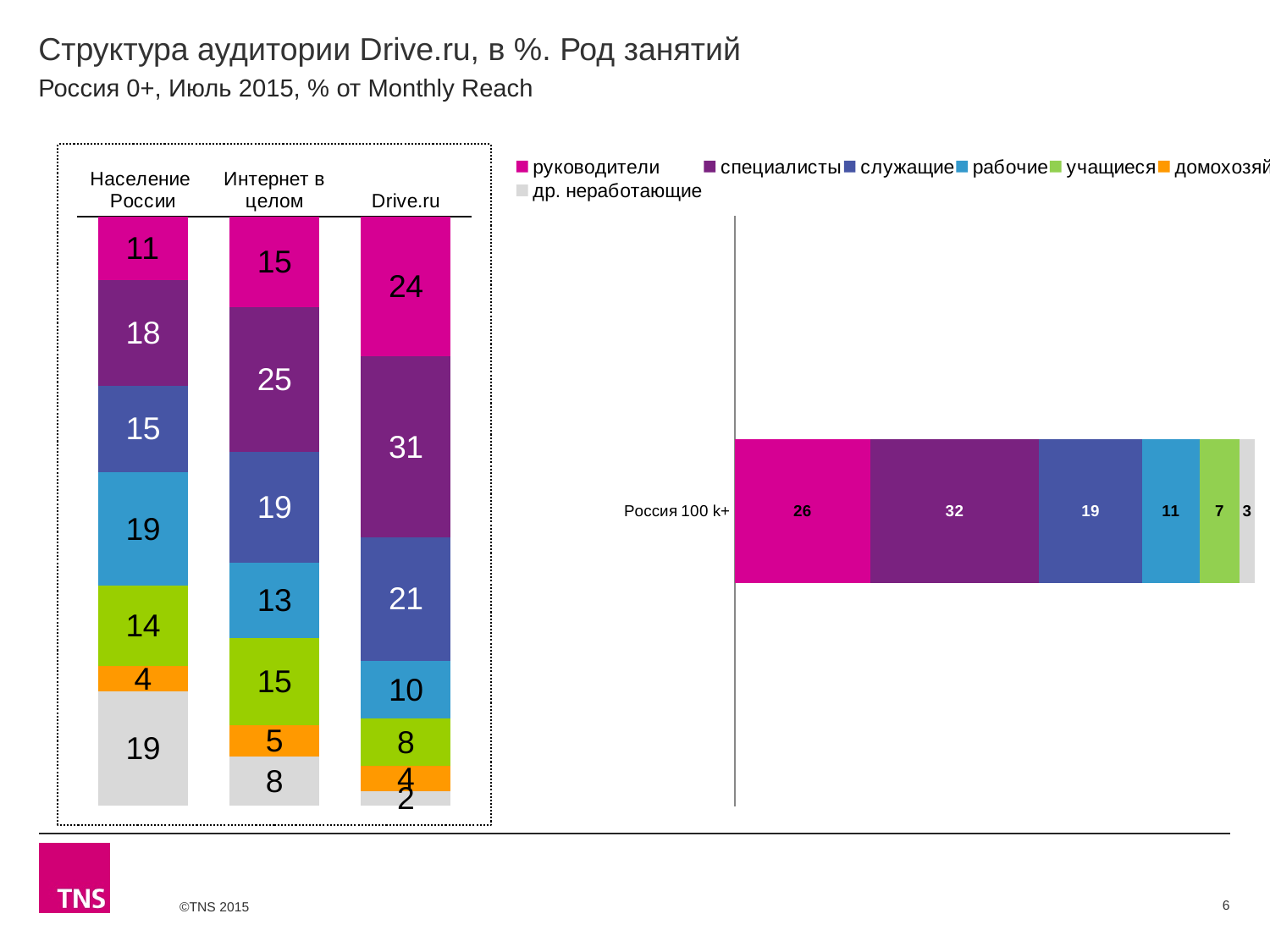
In the left chart, what is the difference between the специалисты value for Drive.ru and for Население России? 13 In the left chart, what is the value for учащиеся in the Население России bar? 14 In the left chart, which of the three bars has the highest value for руководители? Drive.ru In the left chart, which has the larger служащие value: Drive.ru or Интернет в целом? Drive.ru In the right chart, what is the value for руководители for Россия 100 k+? 26 In the left chart, what is the value for рабочие in the Население России bar? 19 How many series does the legend list? 7 What kind of chart is the left chart? Stacked bar chart How many bars (categories) are shown in the left chart? 3 In the left chart, what is the value for специалисты in the Drive.ru bar? 31 In the left chart, what is the value for руководители in the Интернет в целом bar? 15 In the right chart, which series has the largest segment for Россия 100 k+? специалисты